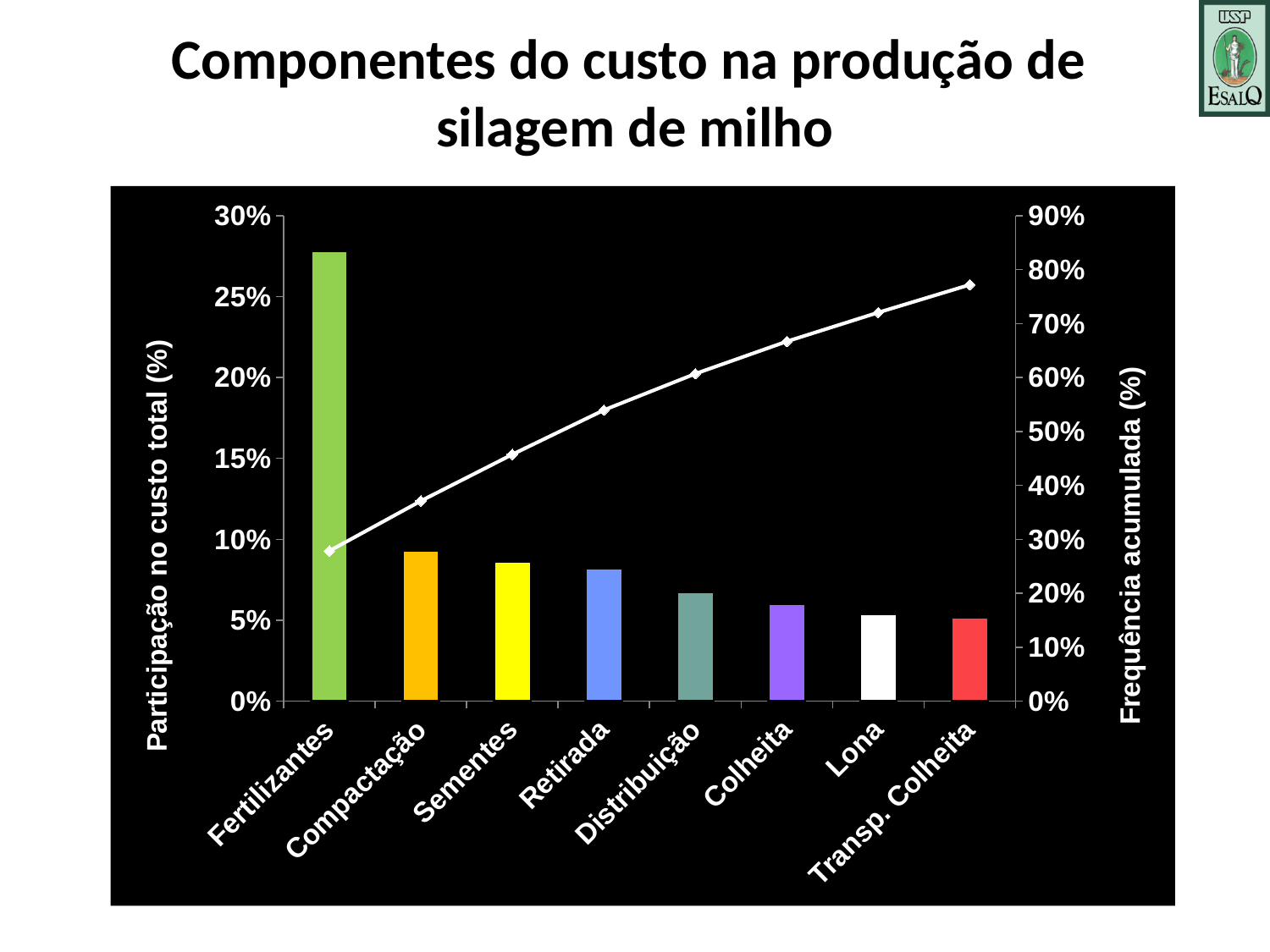
What is the title of the chart on the slide? Componentes do custo na produção de silagem de milho What is the label of the right-hand vertical axis? Frequência acumulada (%) Which has a larger share of the total cost, Compactação or Colheita? Compactação How many cost components are shown on the x axis of the chart? 8 Which has a larger share of the total cost, Lona or Sementes? Sementes Does the cumulative frequency line rise or fall from left to right? rise Is the value for Retirada greater or less than 10%? less Is the value for Fertilizantes greater or less than 25%? greater Is the value for Distribuição greater or less than 5%? greater Which cost component has the highest share of the total cost? Fertilizantes Do the bar values rise or fall from left to right along the x axis? fall